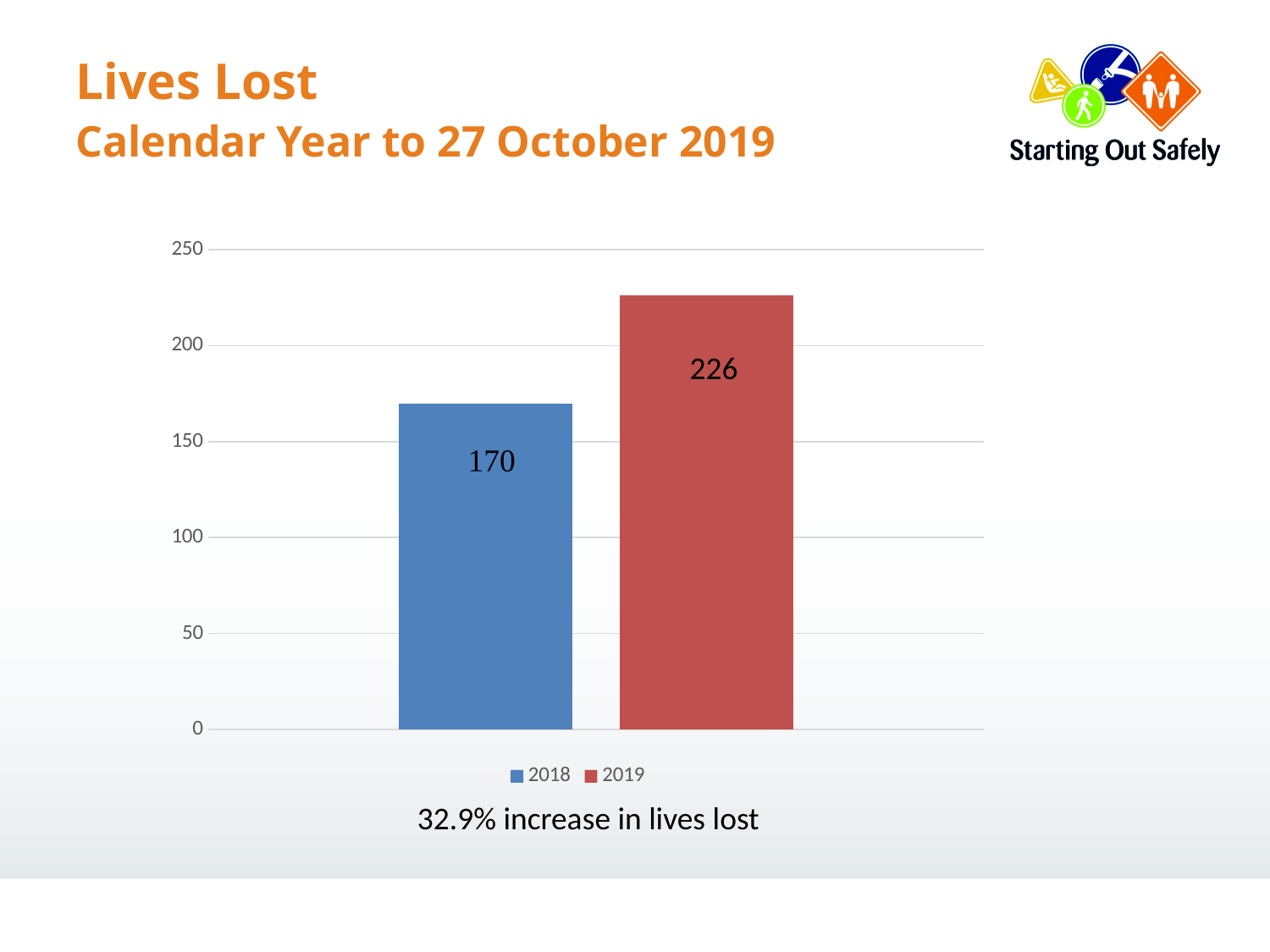
Is the value for 2019 larger than the value for 2018? Yes What kind of chart is shown on the slide? Bar chart What is the value for 2019? 226 Which year has the lower number of lives lost? 2018 What is the value for 2018? 170 What is the difference between the 2019 and 2018 values? 56 Which year has the higher number of lives lost? 2019 Is the value for 2018 greater or less than 200? less How many bars are plotted in the chart? 2 What colour is the bar for 2019? Red Is the value for 2019 greater or less than 200? greater How many series does the legend list? 2